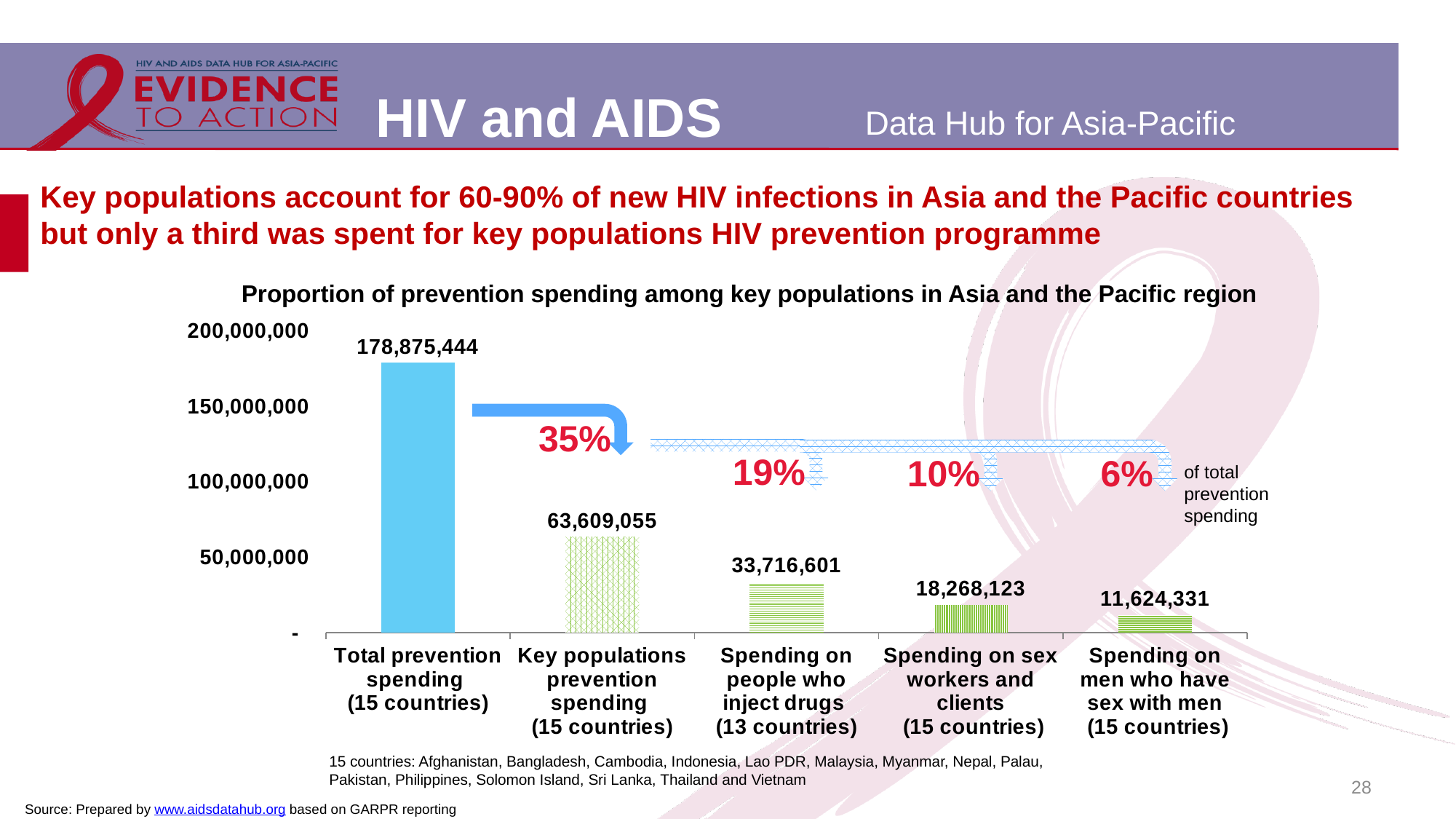
Which category has the lowest value? Spending on men who have sex with men (15 countries) Which category has the highest value? Total prevention spending (15 countries) What percentage of total prevention spending is shown for Spending on sex workers and clients? 10% Which is larger: Spending on people who inject drugs or Spending on sex workers and clients? Spending on people who inject drugs What is the difference between Spending on sex workers and clients and Spending on men who have sex with men? 6,643,792 What kind of chart is shown on the slide? Bar chart What is the value for Spending on people who inject drugs (13 countries)? 33,716,601 What is the value for Total prevention spending (15 countries)? 178,875,444 What is the value for Key populations prevention spending (15 countries)? 63,609,055 What is the difference between Total prevention spending and Key populations prevention spending? 115,266,389 What is the value for Spending on men who have sex with men (15 countries)? 11,624,331 How many categories are shown on the x axis? 5